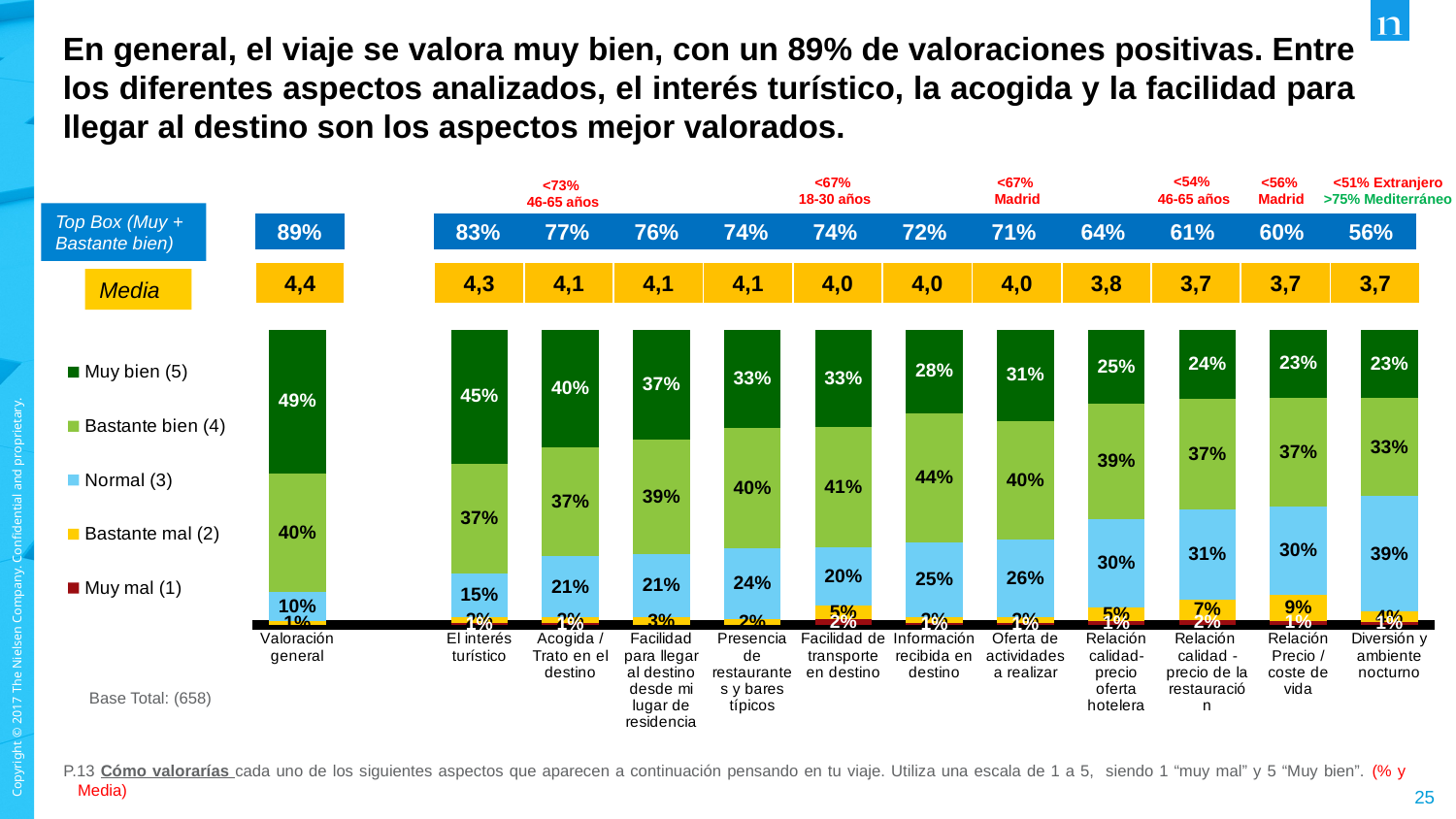
Which has a larger 'Normal (3)' share: 'Relación calidad-precio oferta hotelera' or 'Acogida / Trato en el destino'? Relación calidad-precio oferta hotelera What is the 'Normal (3)' value for 'Diversión y ambiente nocturno'? 39% What kind of chart is shown on the slide? Stacked bar chart What is the Media (mean) value shown for 'El interés turístico'? 4,3 What is the difference in 'Muy bien (5)' percentage between 'Valoración general' and 'El interés turístico'? 4 percentage points What percentage of respondents rated 'Valoración general' as 'Muy bien (5)'? 49% What is the Top Box (Muy + Bastante bien) value for 'Relación Precio / coste de vida'? 60% Which category has the lowest Top Box (Muy + Bastante bien) value? Diversión y ambiente nocturno What is the 'Bastante bien (4)' value for 'Información recibida en destino'? 44% Which category has the highest 'Muy bien (5)' percentage? Valoración general How many categories (bars) are shown in the chart? 12 How many series does the legend list? 5